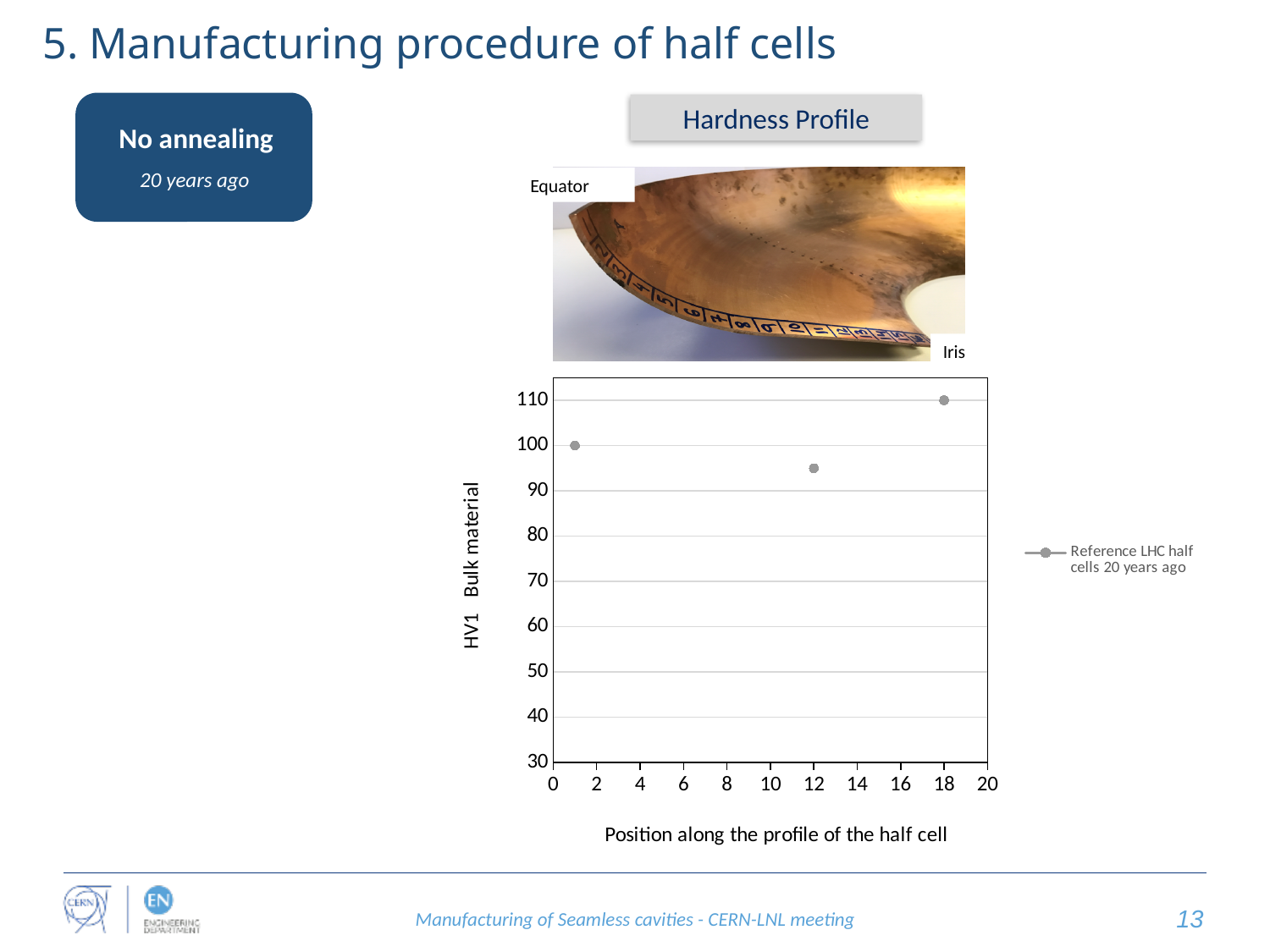
In the Hardness Profile chart, is the value at position 12 greater or less than 90? greater What is the label of the x axis of the Hardness Profile chart? Position along the profile of the half cell How many series does the legend of the Hardness Profile chart list? 1 In the Hardness Profile chart, is the value at position 12 greater or less than 100? less In the Hardness Profile chart, is the value at position 18 greater or less than 100? greater What is the legend entry of the Hardness Profile chart? Reference LHC half cells 20 years ago In the Hardness Profile chart, which has the larger hardness value: the point at position 12 or the point at position 18? position 18 What kind of chart is shown under the Hardness Profile heading? scatter chart At which position along the profile is the hardness value lowest in the Hardness Profile chart? 12 At which position along the profile is the hardness value highest in the Hardness Profile chart? 18 How many data points are plotted in the Hardness Profile chart? 3